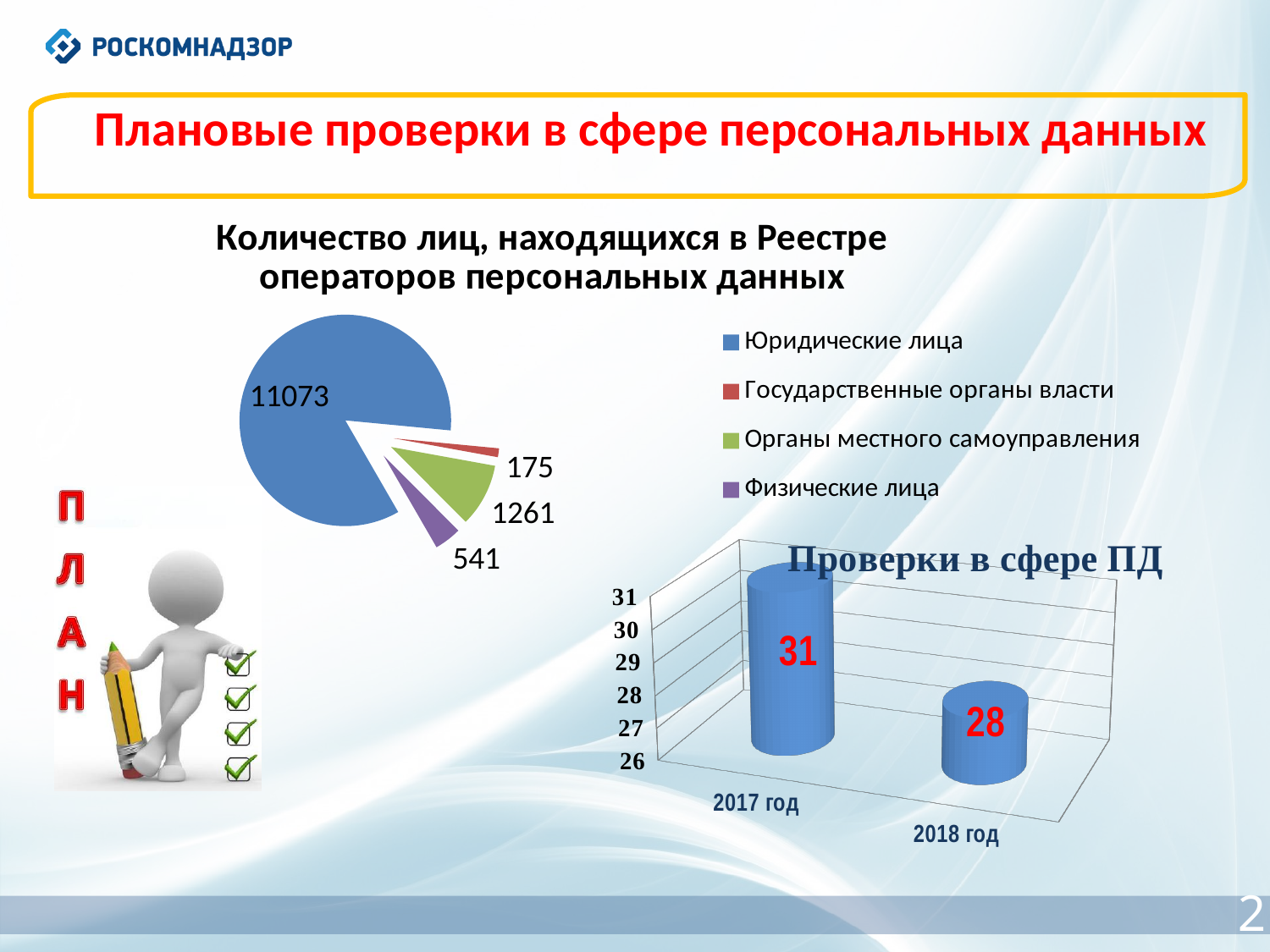
In the pie chart 'Количество лиц, находящихся в Реестре операторов персональных данных', how many categories does the legend list? 4 In the pie chart 'Количество лиц, находящихся в Реестре операторов персональных данных', what is the difference between Органы местного самоуправления and Физические лица? 720 In the pie chart 'Количество лиц, находящихся в Реестре операторов персональных данных', which category has the largest value? Юридические лица In the pie chart 'Количество лиц, находящихся в Реестре операторов персональных данных', what is the value for Органы местного самоуправления? 1261 What kind of chart is 'Проверки в сфере ПД'? Bar chart In the pie chart 'Количество лиц, находящихся в Реестре операторов персональных данных', which category has the smallest value? Государственные органы власти In the pie chart 'Количество лиц, находящихся в Реестре операторов персональных данных', what is the value for Государственные органы власти? 175 In the pie chart 'Количество лиц, находящихся в Реестре операторов персональных данных', what is the value for Юридические лица? 11073 In the pie chart 'Количество лиц, находящихся в Реестре операторов персональных данных', what is the value for Физические лица? 541 In the chart 'Проверки в сфере ПД', what is the value for 2018 год? 28 In the chart 'Проверки в сфере ПД', what is the value for 2017 год? 31 In the chart 'Проверки в сфере ПД', by how much did the value change from 2017 год to 2018 год? 3